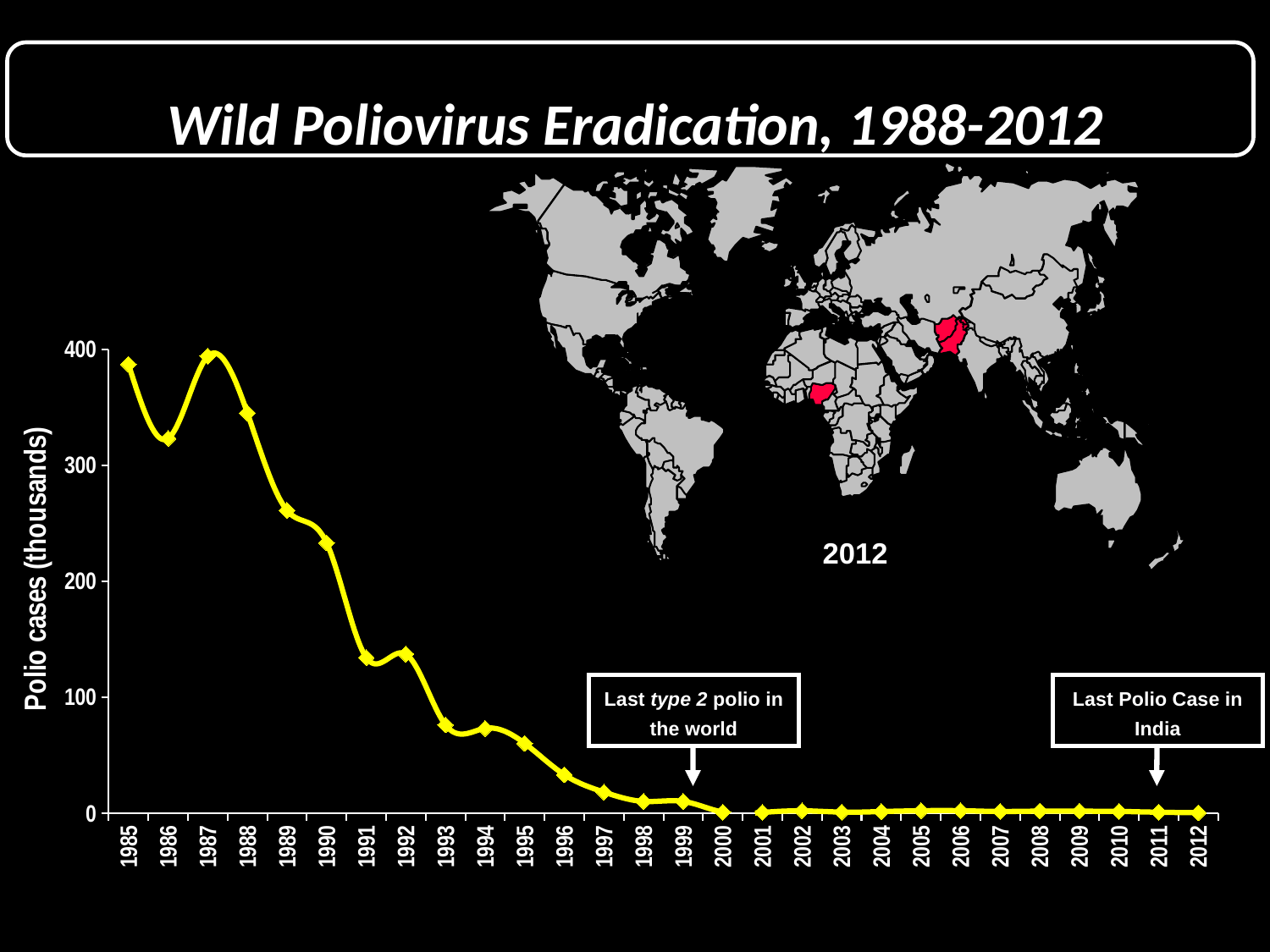
Which year does the annotation 'Last Polio Case in India' point to? 2011 How many years are plotted along the x axis of the chart? 28 Is the value for 1993 greater or less than 100? less What kind of chart is shown on the slide? line chart Which year has the higher value, 1989 or 1990? 1989 Is the value for 1989 greater or less than 200? greater Is the value for 1991 greater or less than 100? greater Which year has the higher value, 1985 or 1986? 1985 Overall, do polio cases rise or fall from 1985 to 2012 in the chart? fall What is the label on the y axis of the chart? Polio cases (thousands)